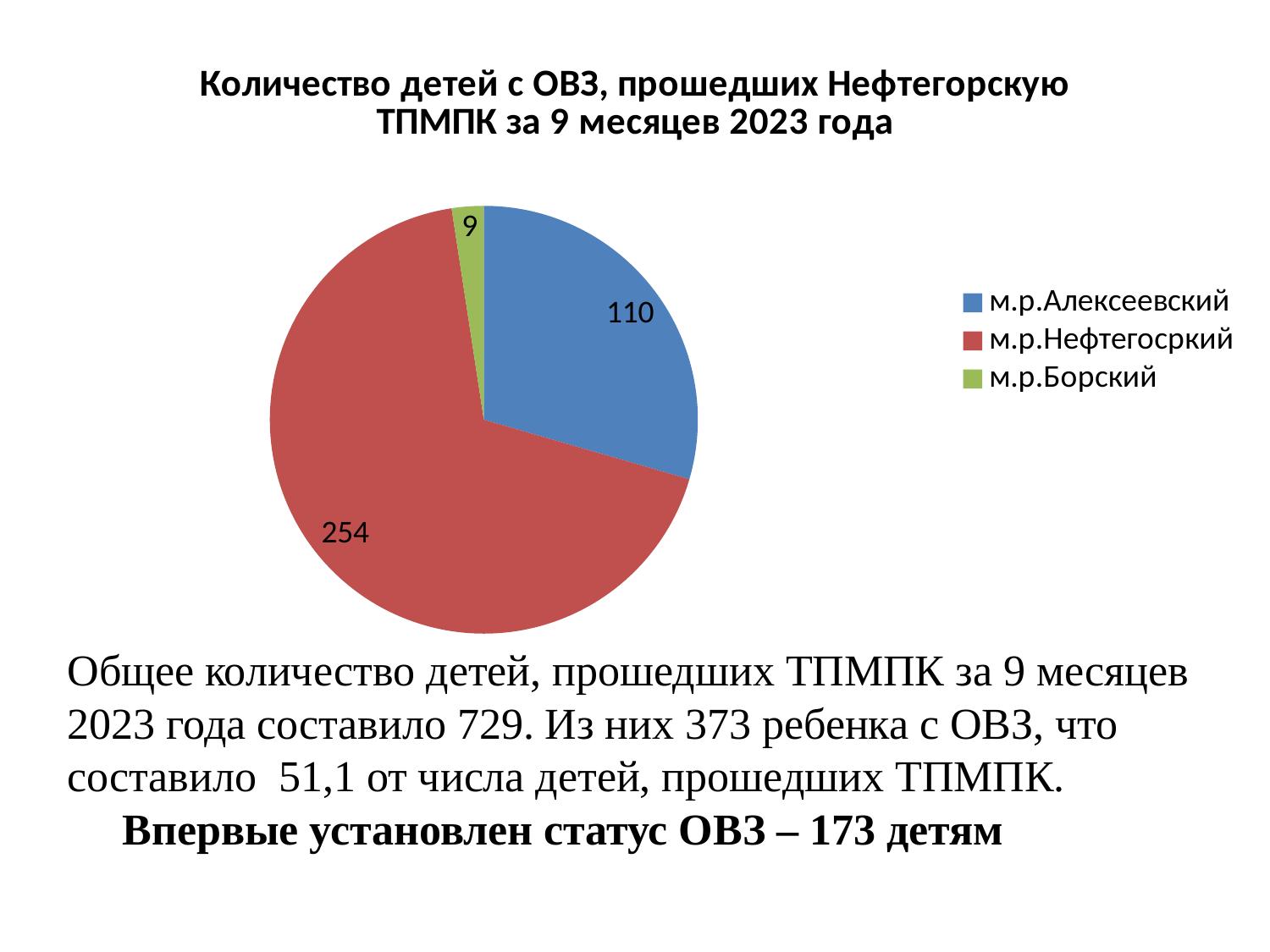
How many entries does the legend list? 3 What colour is the slice for м.р.Борский? green Which category has the smallest slice of the pie? м.р.Борский What is the value for м.р.Борский? 9 How many slices does the pie chart have? 3 What is the value for м.р.Алексеевский? 110 Which is larger, the value for м.р.Алексеевский or the value for м.р.Борский? м.р.Алексеевский What kind of chart is shown on the slide? pie chart Which category has the largest slice of the pie? м.р.Нефтегосркий What is the value for м.р.Нефтегосркий? 254 What is the difference between the values for м.р.Нефтегосркий and м.р.Алексеевский? 144 What is the total of all slices in the pie chart? 373